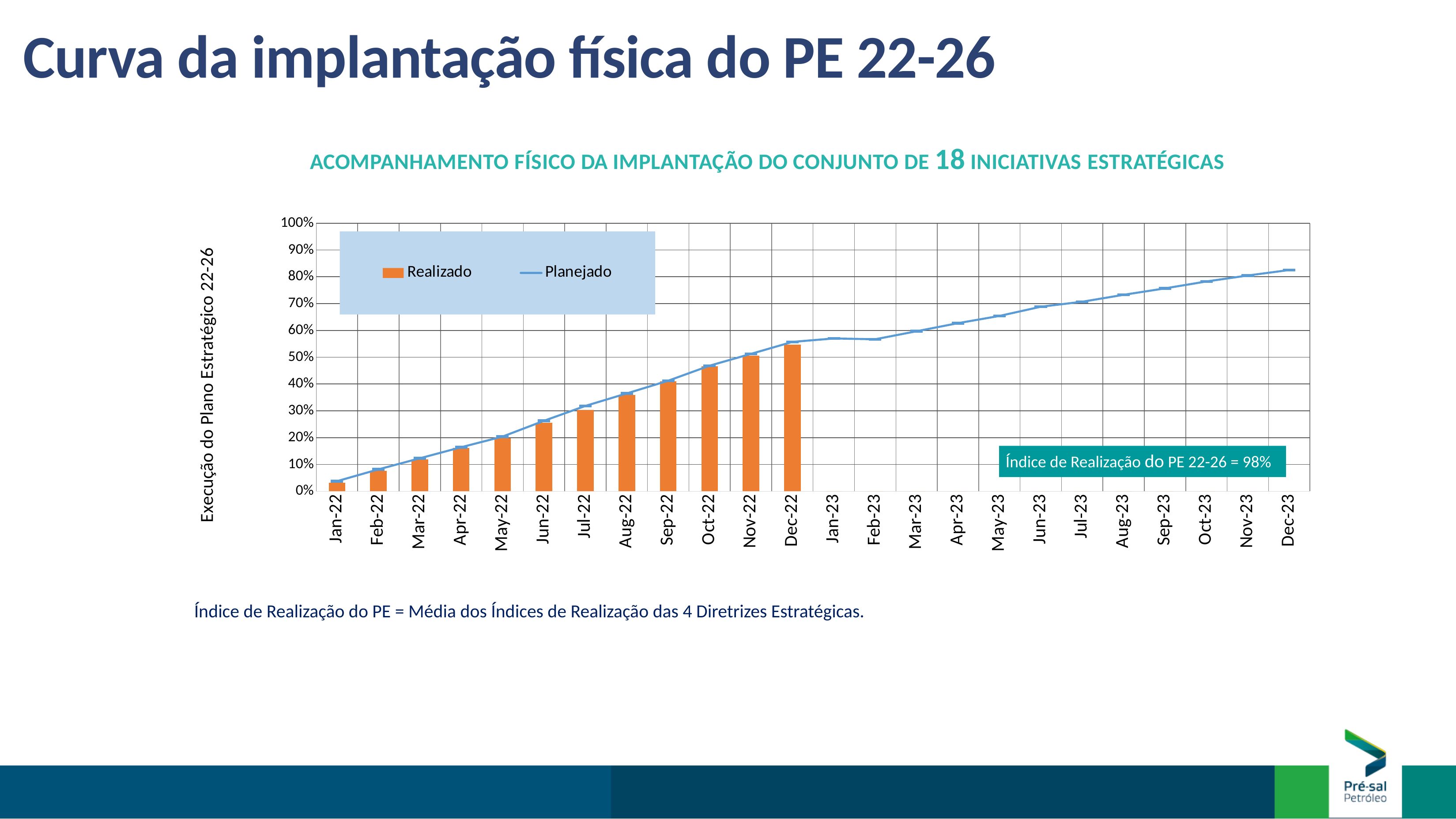
Which is larger, the Realizado value for Jun-22 or for Oct-22? Oct-22 How many series does the chart legend list? 2 How many months are labelled on the x axis of the chart? 24 How many orange Realizado bars are plotted on the chart? 12 Is the Realizado value for Dec-22 greater or less than 50%? greater Is the Planejado value for Dec-23 greater or less than 80%? greater Which month has the highest Realizado bar? Dec-22 Is the Realizado value for Jan-22 greater or less than 10%? less What kind of chart is shown on the slide? A combined bar and line chart Does the Planejado line rise or fall from Jan-22 to Dec-23? Rises What is the title of the y axis of the chart? Execução do Plano Estratégico 22-26 Which month has the lowest Realizado bar? Jan-22